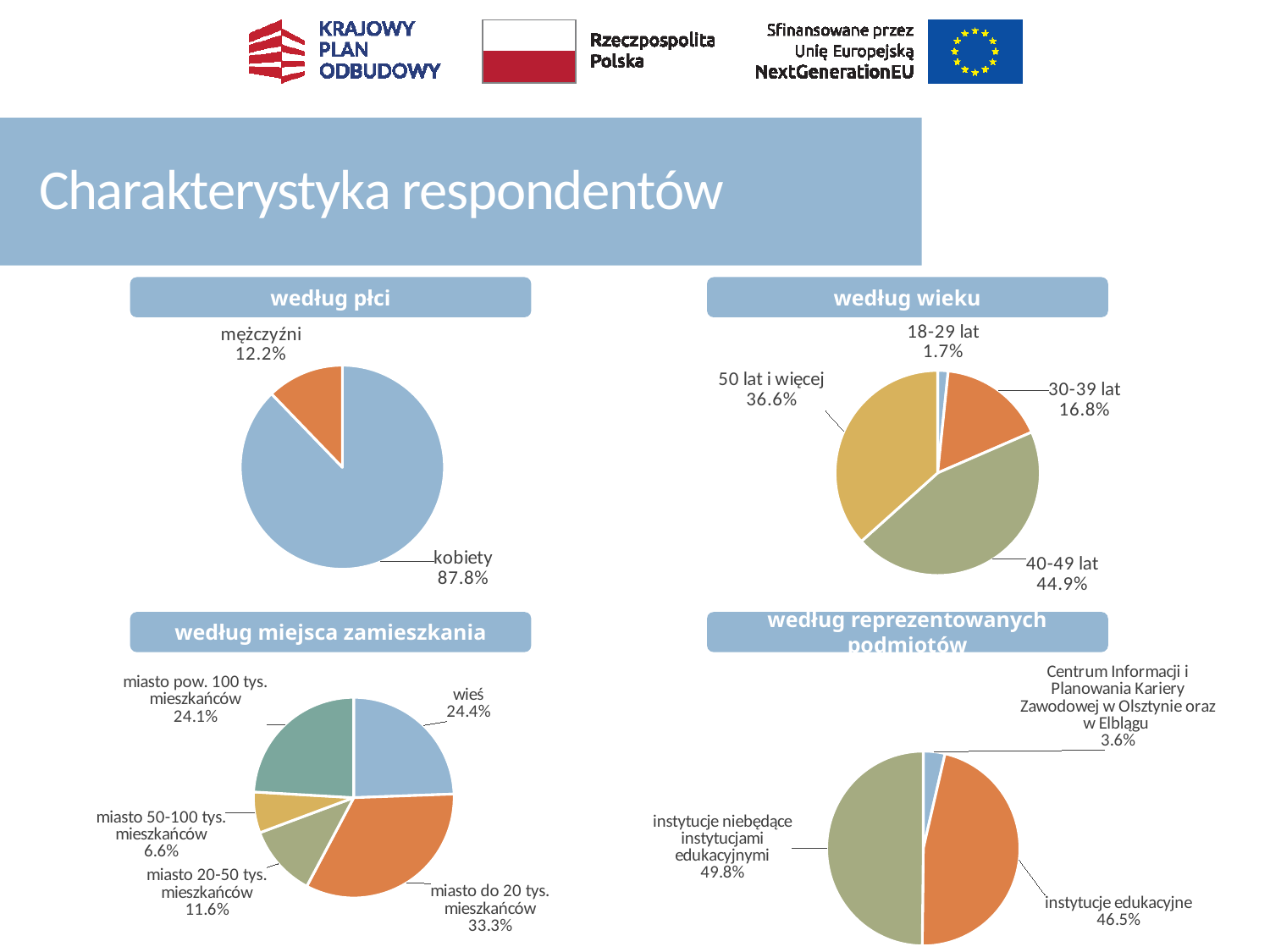
In the 'według płci' chart, what share is labelled for mężczyźni? 12.2% In the 'według miejsca zamieszkania' chart, how many categories are shown? 5 In the 'według reprezentowanych podmiotów' chart, what share is labelled for instytucje edukacyjne? 46.5% In the 'według miejsca zamieszkania' chart, what share is labelled for miasto 20-50 tys. mieszkańców? 11.6% In the 'według wieku' chart, which age group has the largest share? 40-49 lat What type of chart is used for 'według reprezentowanych podmiotów'? pie chart In the 'według miejsca zamieszkania' chart, which is larger: wieś or miasto pow. 100 tys. mieszkańców? wieś In the 'według wieku' chart, which age group has the smallest share? 18-29 lat In the 'według wieku' chart, what share is labelled for 50 lat i więcej? 36.6% In the 'według płci' chart, what share is labelled for kobiety? 87.8% In the 'według miejsca zamieszkania' chart, which category has the largest share? miasto do 20 tys. mieszkańców In the 'według wieku' chart, what is the difference in percentage points between 40-49 lat and 30-39 lat? 28.1